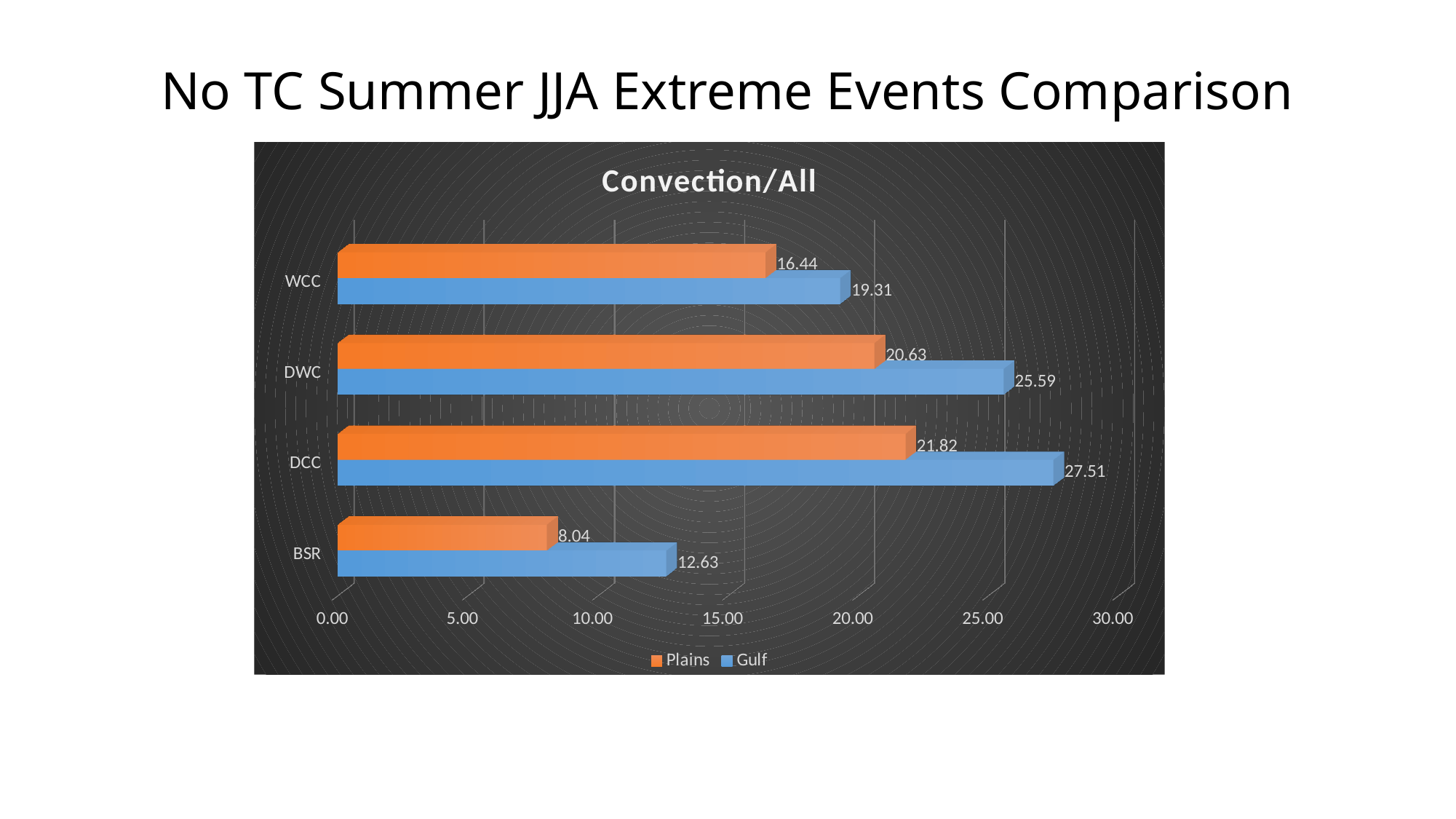
What is the difference between the Gulf and Plains values for DWC? 4.96 What is the Plains value for WCC? 16.44 How many categories are shown on the chart? 4 What is the Gulf value for BSR? 12.63 Which is larger for WCC, the Plains value or the Gulf value? Gulf How many series does the legend list? 2 What is the Plains value for DWC? 20.63 Which category has the highest Gulf value? DCC What kind of chart is shown on the slide? Bar chart What is the title of the chart? Convection/All What is the Gulf value for DCC? 27.51 Which category has the lowest Plains value? BSR